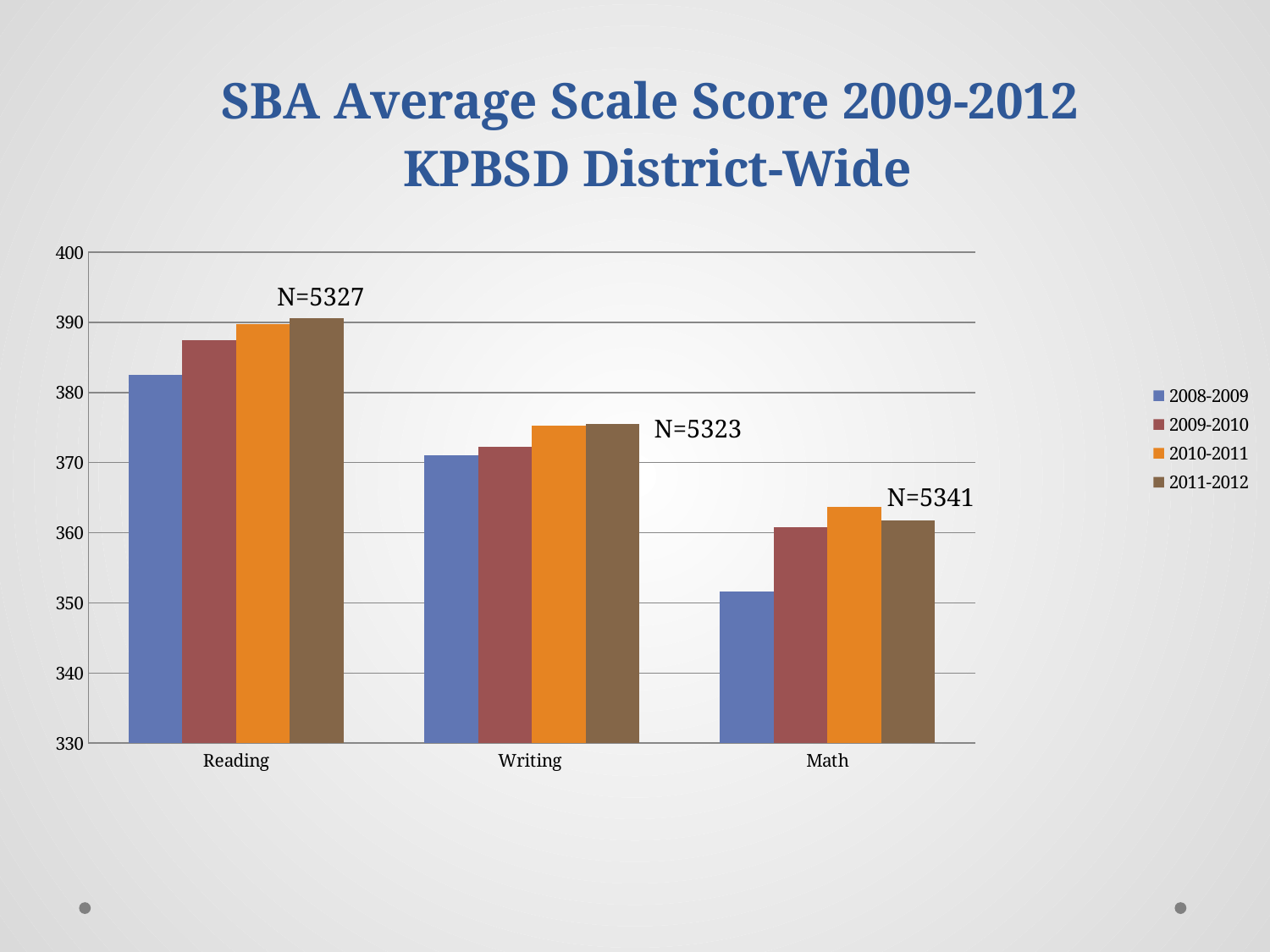
Is the value for Math in 2008-2009 greater or less than 360? less Do the Reading scores rise or fall from 2008-2009 to 2011-2012? rise What N value is annotated above the Math bars? N=5341 How many subject categories are shown on the x axis? 3 Which subject has the highest average scale scores overall? Reading Is the value for Reading in 2008-2009 greater or less than 380? greater Is the value for Writing in 2008-2009 greater or less than 380? less Which is larger: the Math score for 2010-2011 or the Math score for 2008-2009? 2010-2011 How many series does the legend list? 4 What kind of chart is shown on the slide? bar chart Which series has the lowest bar in the Math category? 2008-2009